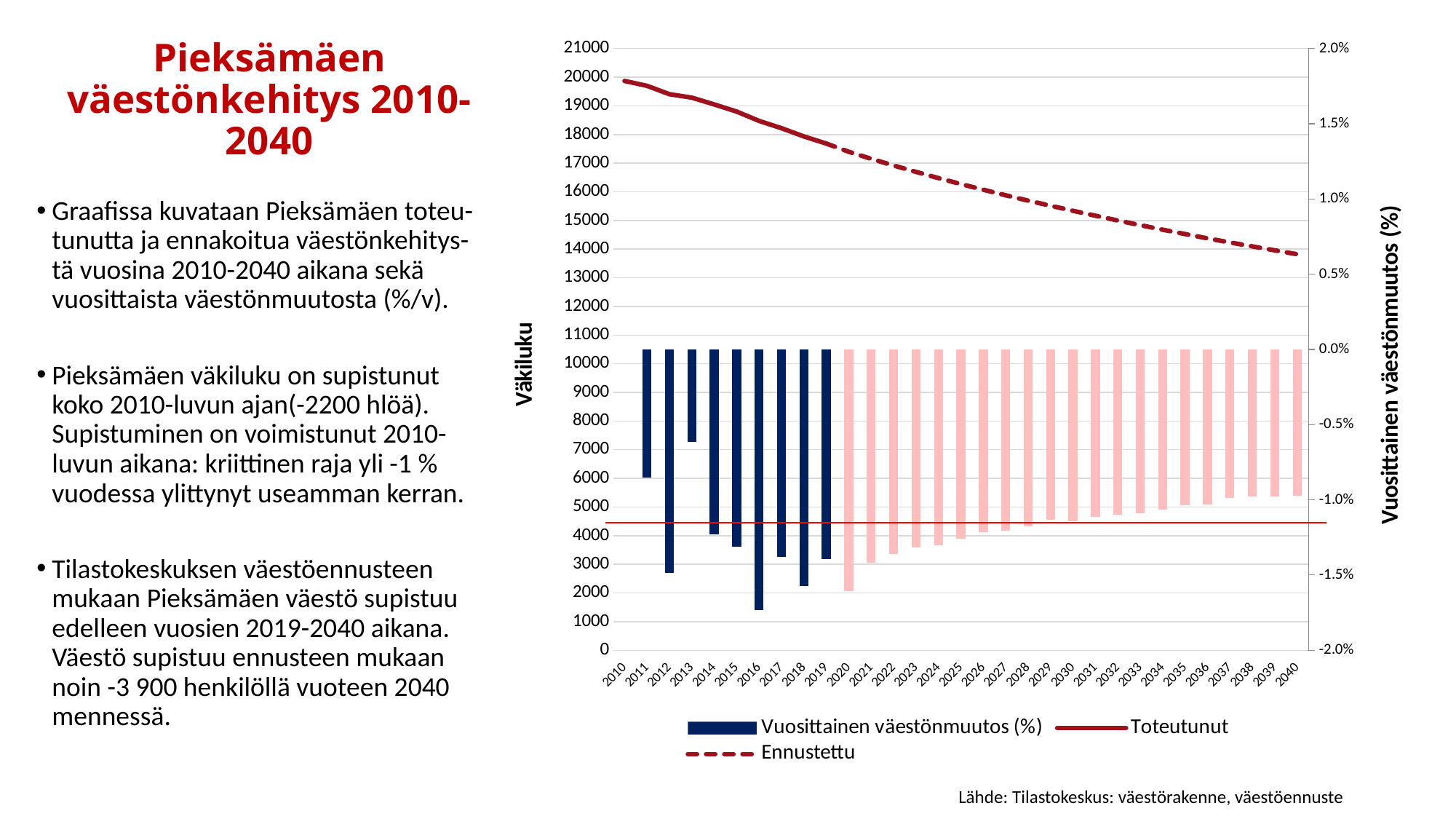
What are the three series named in the legend? Vuosittainen väestönmuutos (%), Toteutunut, Ennustettu Is the Ennustettu population value for 2040 greater or less than 15000? less Which year has the larger (less negative) annual population change, 2012 or 2013? 2013 What is the title of the left vertical axis? Väkiluku Is the Toteutunut population value for 2010 greater or less than 19000? greater How many years are shown on the x axis of the chart? 31 Which year has the lowest (most negative) annual population change bar? 2016 What kind of chart is shown on the slide? A combined bar and line chart Is the annual population change for 2016 greater or less than -1.5%? less Does the population (Väkiluku) line rise or fall from 2010 to 2040? Fall How many series does the chart legend list? 3